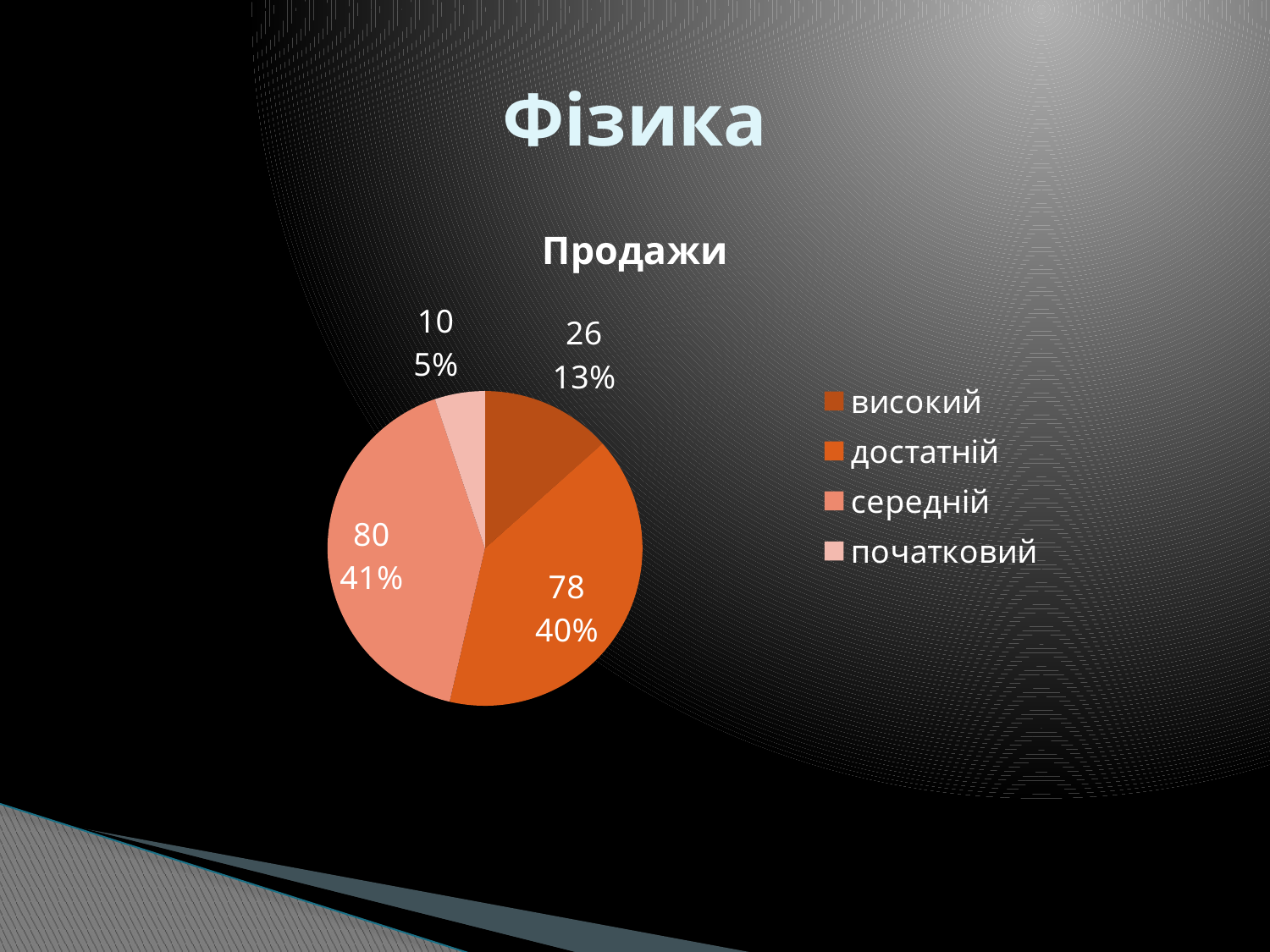
What share of the pie does високий take? 13% What is the value for достатній? 78 What share of the pie does середній take? 41% Which category has the smallest value? початковий How many entries does the legend list? 4 What is the difference between the values for достатній and високий? 52 How many slices does the pie chart have? 4 What is the title of the chart? Продажи What kind of chart is shown on the slide? pie chart Which category has the largest value? середній What is the value for початковий? 10 What is the value for високий? 26